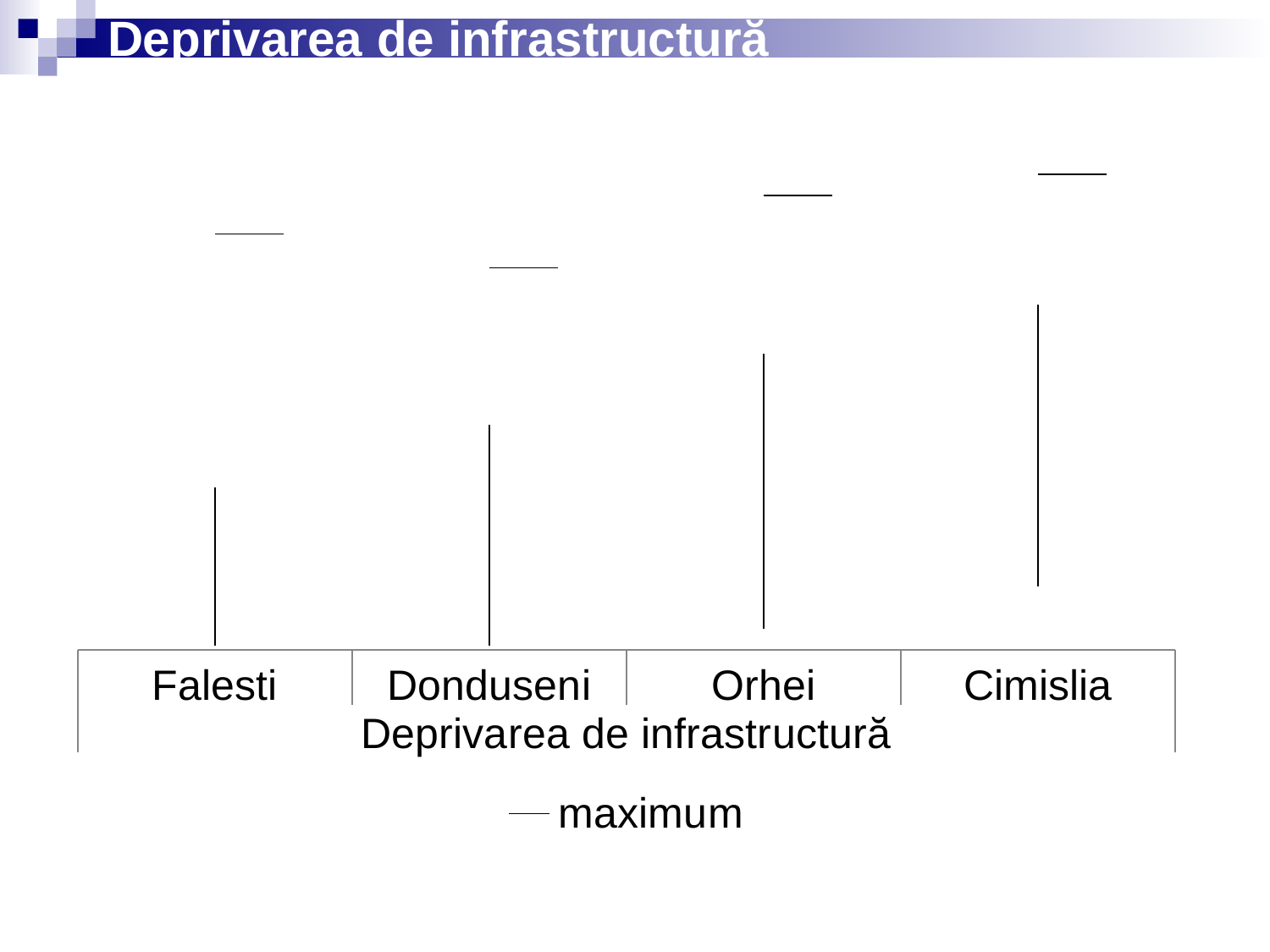
Which category has the lowest 'maximum' marker in the chart? Donduseni Is the 'maximum' marker for Donduseni higher or lower than the one for Falesti? lower Which category has the highest 'maximum' marker in the chart? Cimislia Is the 'maximum' marker for Orhei higher or lower than the one for Falesti? higher Is the 'maximum' marker for Cimislia higher or lower than the one for Orhei? higher How many categories are shown on the x axis of the chart? 4 What is the name of the series listed in the chart legend? maximum What is the title of the chart's x axis? Deprivarea de infrastructură Which category is listed first on the x axis of the chart? Falesti How many series does the chart legend list? 1